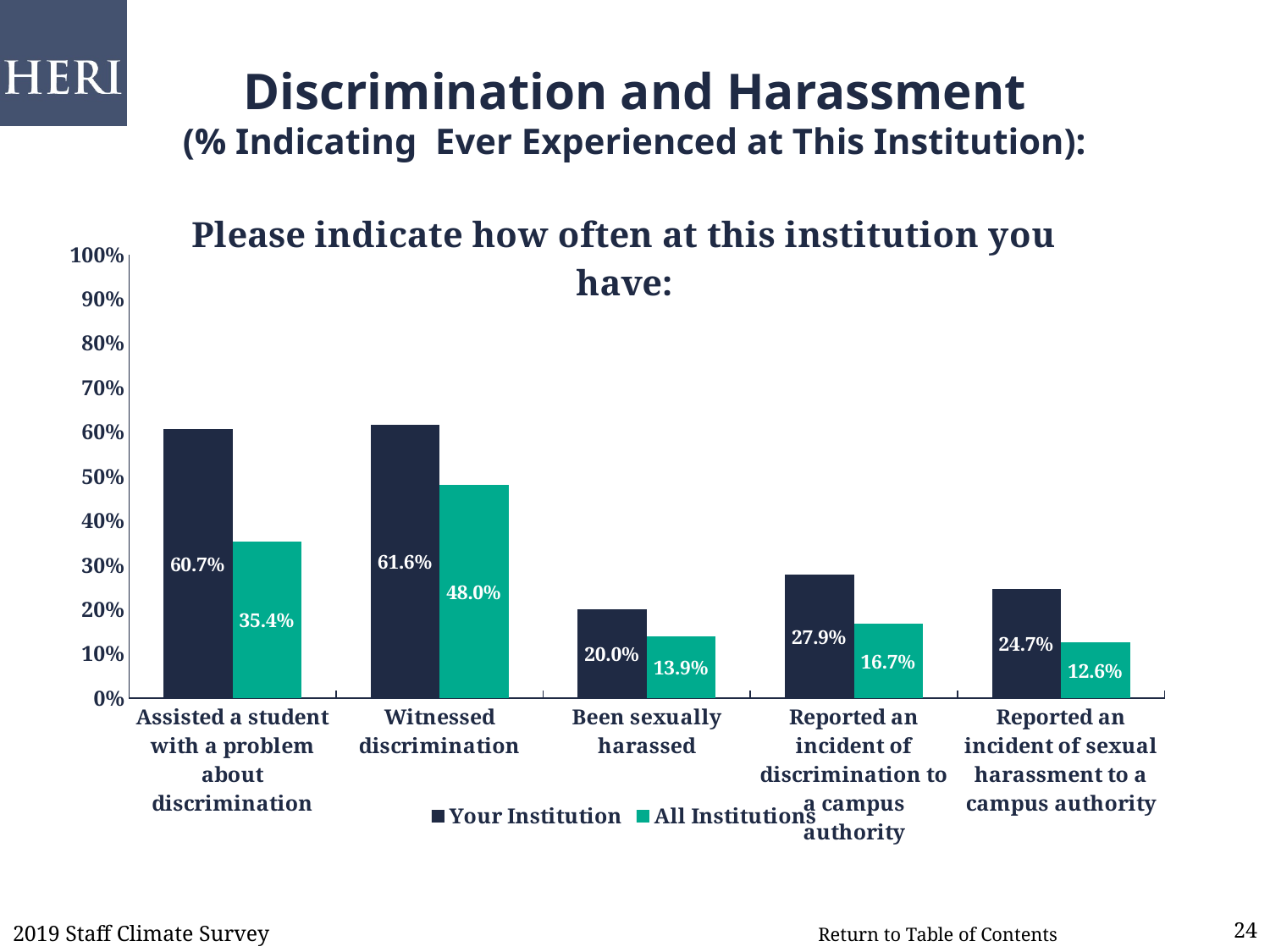
Which is larger for "Reported an incident of discrimination to a campus authority": "Your Institution" or "All Institutions"? Your Institution What is the value for "Your Institution" for "Witnessed discrimination"? 61.6% What kind of chart is shown on the slide? bar chart How many categories are shown on the x axis? 5 What is the value for "All Institutions" for "Been sexually harassed"? 13.9% Is the value for "Your Institution" for "Been sexually harassed" greater or less than 30%? less How many series does the legend list? 2 What are the two series listed in the legend? Your Institution and All Institutions What is the difference between "Your Institution" and "All Institutions" for "Assisted a student with a problem about discrimination"? 25.3% What is the value for "All Institutions" for "Assisted a student with a problem about discrimination"? 35.4% Which category has the highest value for "Your Institution"? Witnessed discrimination Which category has the lowest value for "All Institutions"? Reported an incident of sexual harassment to a campus authority